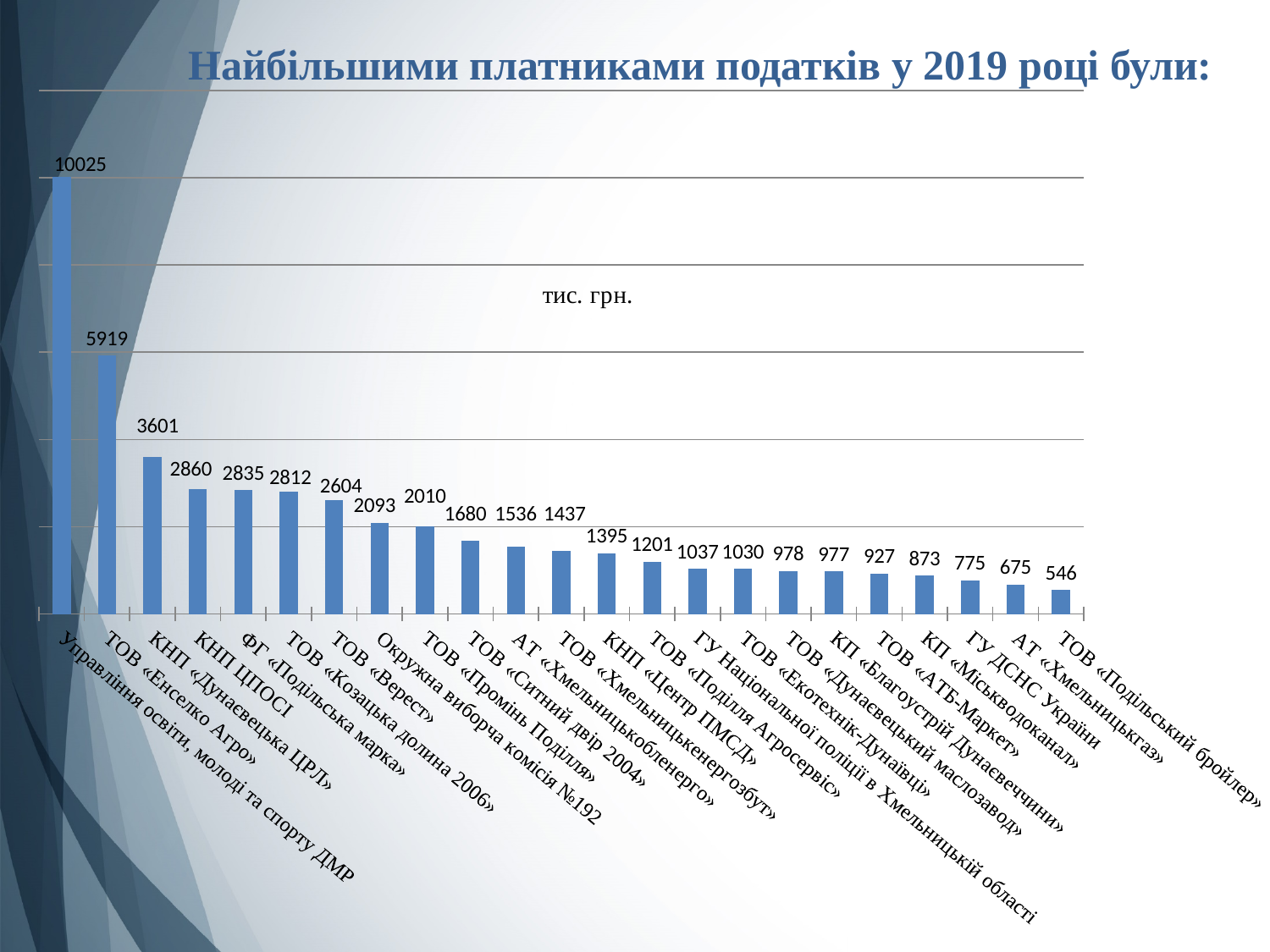
What is the value for Окружна виборча комісія №192? 2093 What is the difference between the values for Управління освіти, молоді та спорту ДМР and ТОВ «Енселко Агро»? 4106 Which is larger, the value for ТОВ «Промінь Поділля» or the value for ТОВ «Ситний двір 2004»? ТОВ «Промінь Поділля» What unit is indicated on the chart? тис. грн. Which category has the highest value? Управління освіти, молоді та спорту ДМР What is the difference between the values for КНП «Дунаєвецька ЦРЛ» and ТОВ «Верест»? 997 How many categories are shown in the chart? 23 What is the value for Управління освіти, молоді та спорту ДМР? 10025 What kind of chart is shown on the slide? Bar chart What is the value for ТОВ «Енселко Агро»? 5919 What is the value for ТОВ «АТБ-Маркет»? 927 Which category has the lowest value? ТОВ «Подільський бройлер»